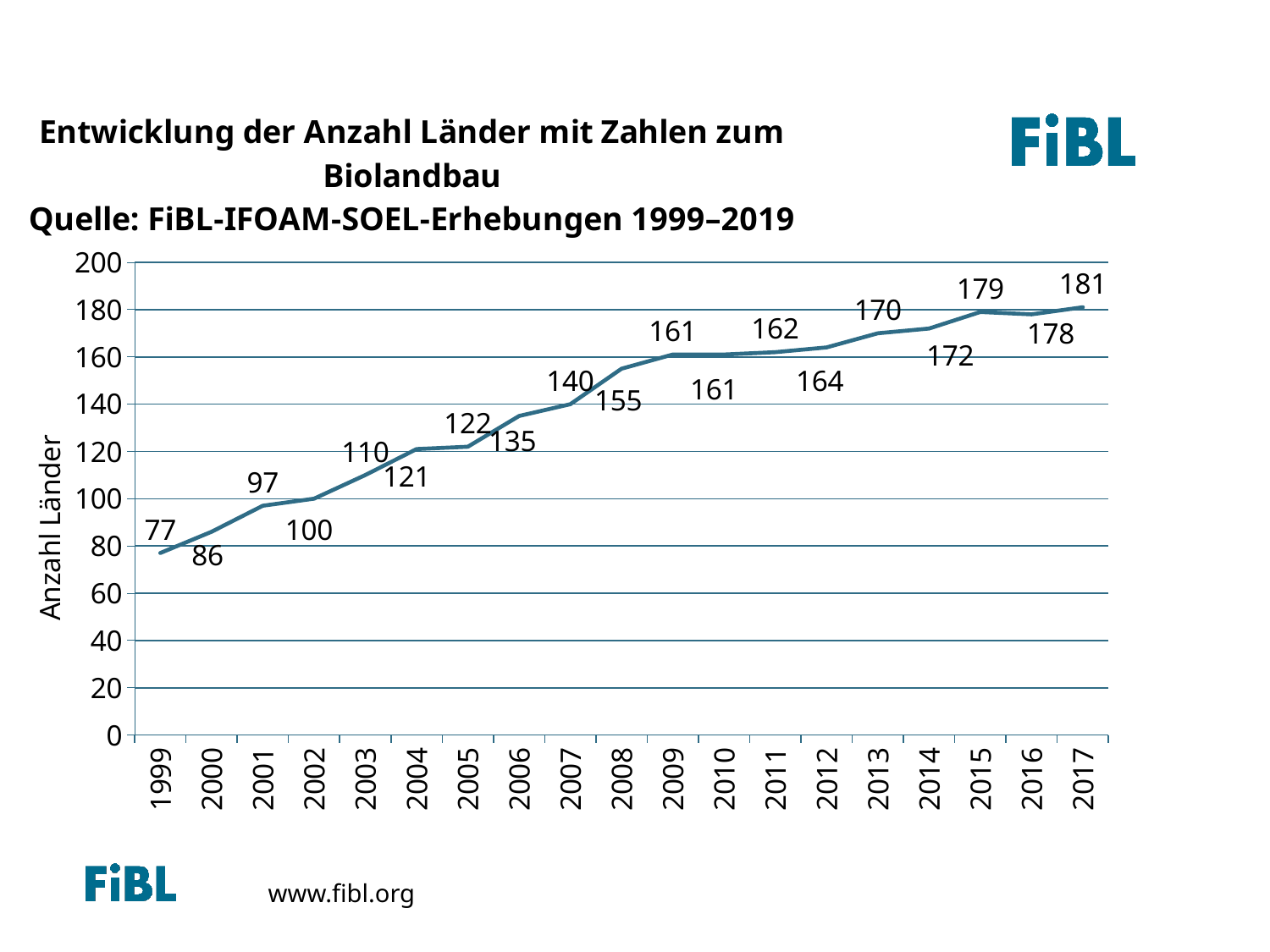
What is the label of the y axis? Anzahl Länder What is the value for 2016? 178 Which year has the lowest value? 1999 What is the value for 2008? 155 What is the difference between the values for 2017 and 1999? 104 Do the values generally rise or fall from 1999 to 2017? rise Which year has the highest value? 2017 Which is larger, the value for 2015 or the value for 2016? 2015 What is the difference between the values for 2006 and 2005? 13 What type of chart is shown on the slide? line chart What is the value for 1999? 77 How many years are plotted on the x axis? 19